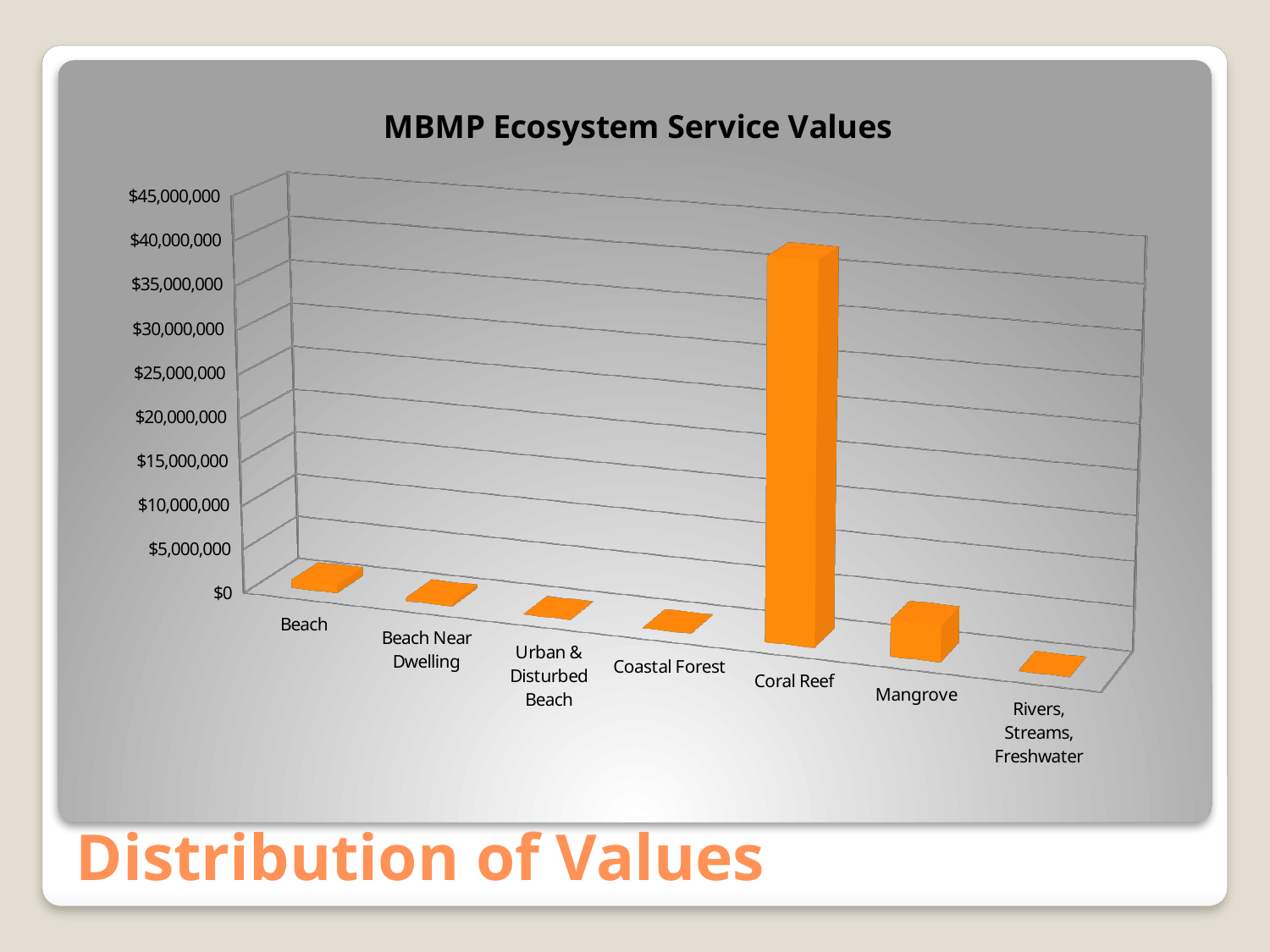
Which category has the highest ecosystem service value? Coral Reef Is the value for Mangrove greater or less than $10,000,000? less Is the value for Coral Reef greater or less than $30,000,000? greater Which is larger, the value for Coral Reef or the value for Mangrove? Coral Reef Which is larger, the value for Beach or the value for Coastal Forest? Beach What colour are the bars in the chart? orange Is the value for Beach greater or less than $5,000,000? less How many categories are plotted on the x axis? 7 What is the title of the chart? MBMP Ecosystem Service Values What kind of chart is shown on the slide? bar chart Which is larger, the value for Mangrove or the value for Beach Near Dwelling? Mangrove